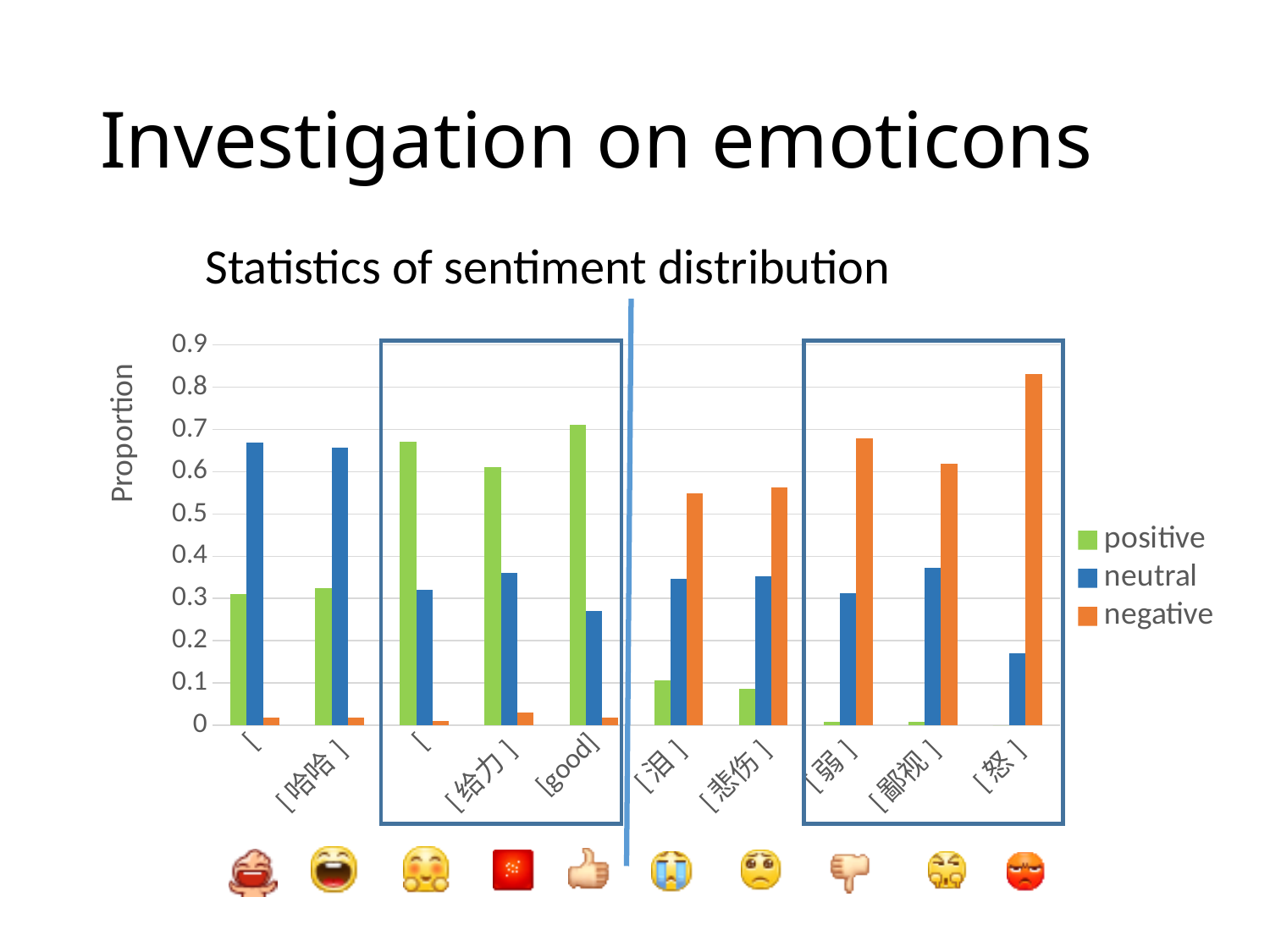
How many series does the legend list? 3 Which category has the highest negative value? [怒] Is the negative value for [弱] greater or less than 0.6? greater For [哈哈], which is larger: the positive value or the neutral value? neutral What is the label on the y axis? Proportion Is the negative value for [怒] greater or less than 0.8? greater Is the positive value for [泪] greater or less than 0.2? less How many emoticon categories are plotted along the x axis? 10 What is the title of the chart? Statistics of sentiment distribution For [good], which is larger: the positive value or the neutral value? positive What kind of chart is shown on the slide? bar chart